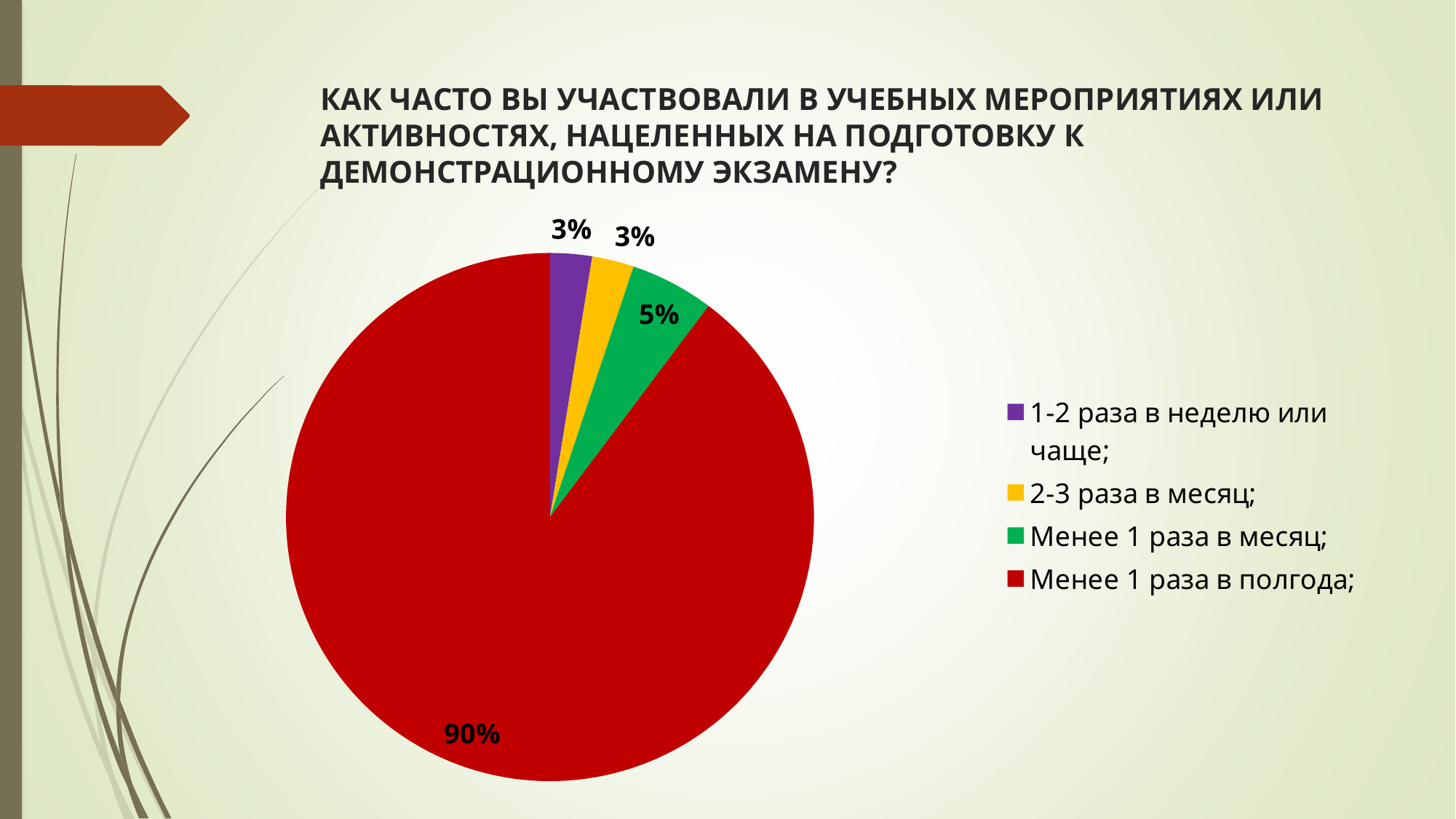
How many categories does the legend list? 4 What is the difference between the shares for "Менее 1 раза в полгода" and "Менее 1 раза в месяц"? 85% What colour is the slice for "1-2 раза в неделю или чаще"? purple What share of the pie is labelled for "Менее 1 раза в полгода"? 90% What type of chart is shown on the slide? pie chart What share of the pie is labelled for "Менее 1 раза в месяц"? 5% Which category has the largest slice of the pie? Менее 1 раза в полгода What share of the pie is labelled for "2-3 раза в месяц"? 3% What is the combined share of "1-2 раза в неделю или чаще" and "2-3 раза в месяц"? 6% Which is larger: the share for "Менее 1 раза в месяц" or the share for "2-3 раза в месяц"? Менее 1 раза в месяц What colour is the slice for "Менее 1 раза в полгода"? red What share of the pie is labelled for "1-2 раза в неделю или чаще"? 3%